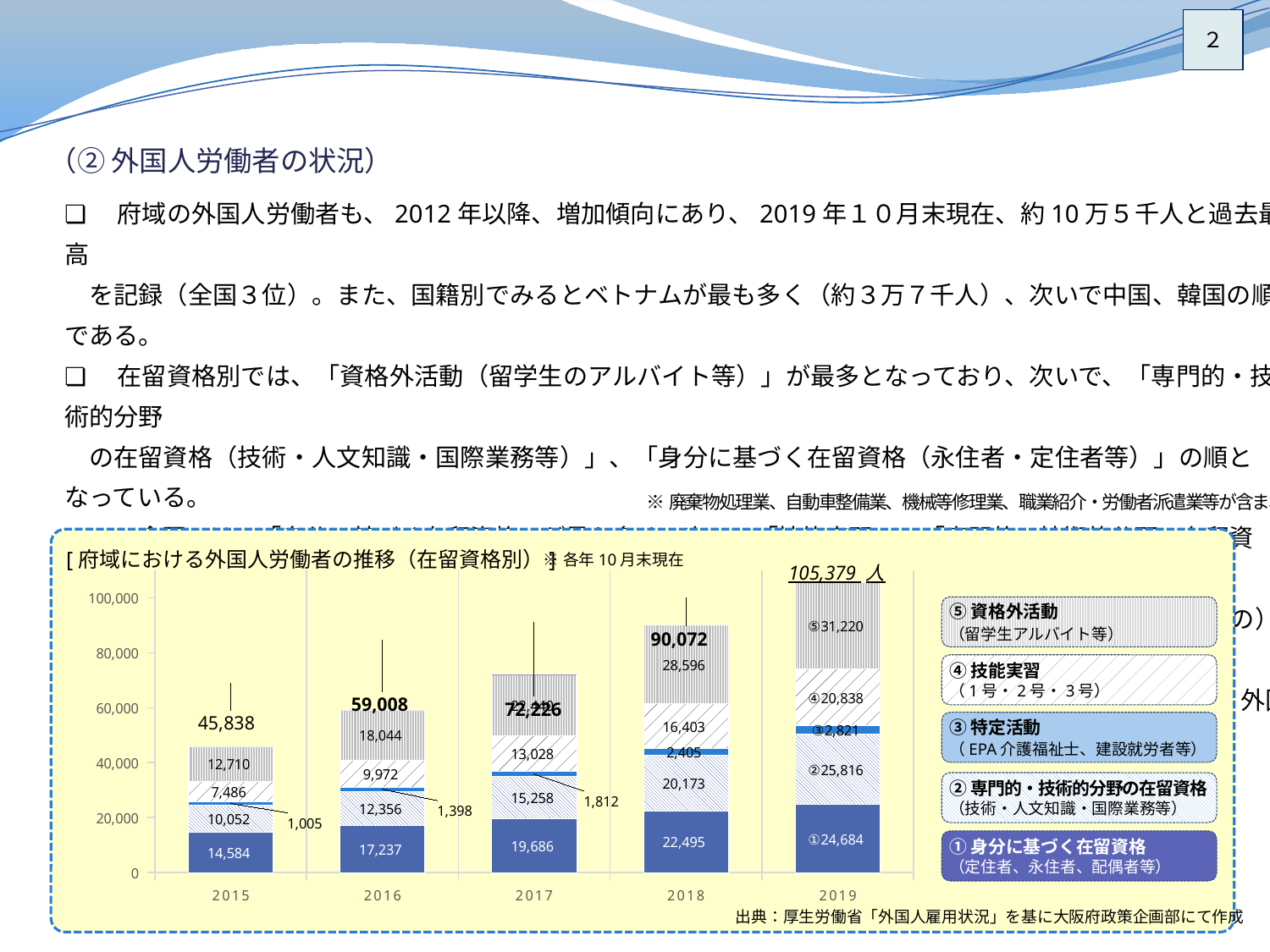
How many residence-status categories does the legend list? 5 Do the total numbers of foreign workers rise or fall from 2015 to 2019? Rise What is the value for ③特定活動 in 2016? 1,398 What is the difference between the 2019 total (105,379) and the 2018 total (90,072)? 15,307 How many years are shown on the x axis of the chart? 5 What is the total number of foreign workers shown for 2015? 45,838 What kind of chart is shown on the slide? Stacked bar chart What is the value for ①身分に基づく在留資格 in 2018? 22,495 Which year has the lowest total number of foreign workers? 2015 What is the value for ⑤資格外活動 in 2019? 31,220 Which year has the highest total number of foreign workers? 2019 What is the total number of foreign workers shown for 2019? 105,379